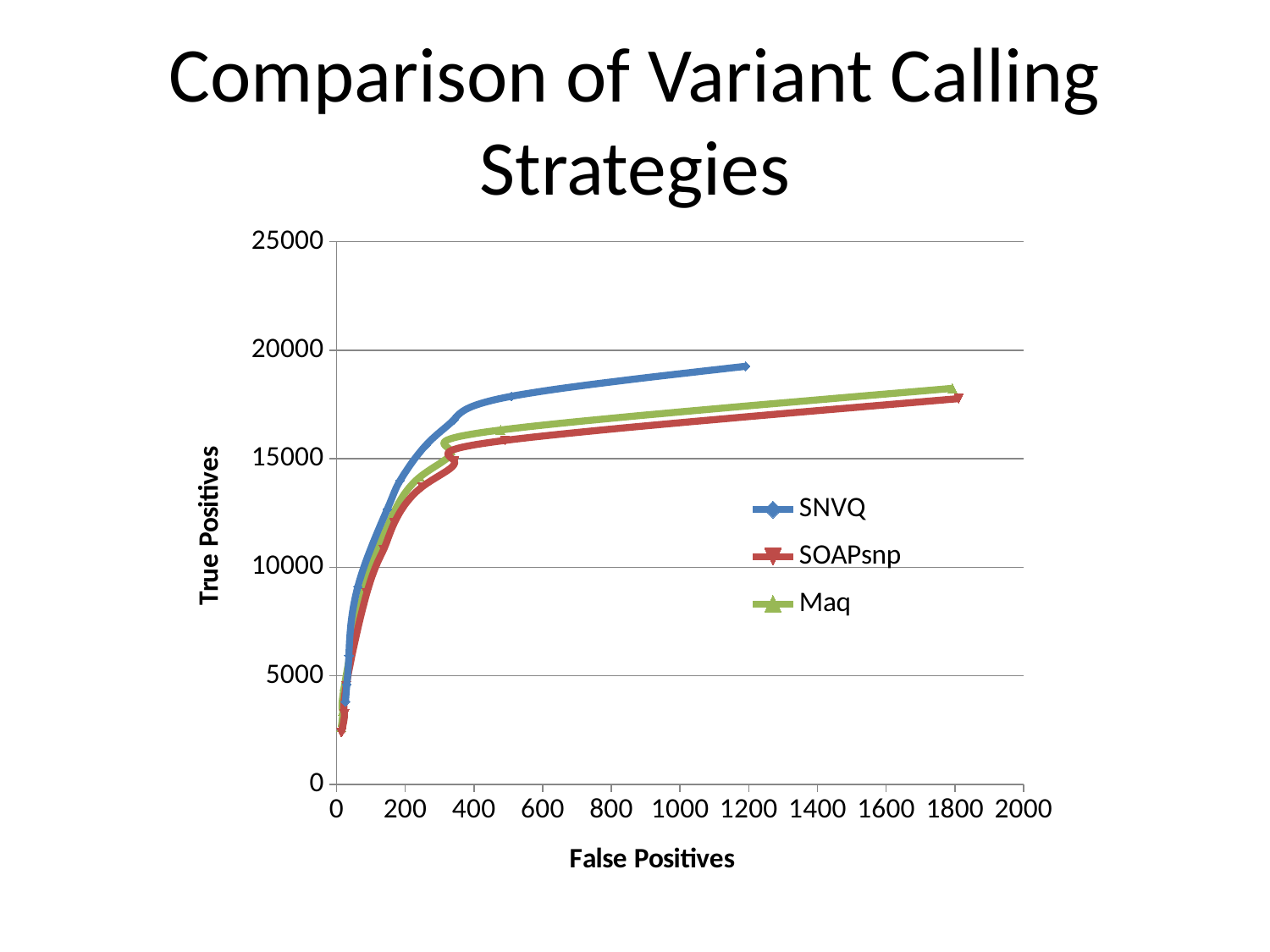
What is the label of the x axis? False Positives Is the lowest True Positives value of the SOAPsnp series greater or less than 5000? less Do the True Positives values rise or fall as False Positives increase along the x axis? rise Is the largest False Positives value reached by Maq greater or less than 1600? greater At 1800 False Positives, which series has more True Positives, Maq or SOAPsnp? Maq Is the highest True Positives value reached by SNVQ greater or less than 20000? less What is the title of the chart? Comparison of Variant Calling Strategies How many series does the legend list? 3 What kind of chart is shown on the slide? line chart Which series reaches the highest number of True Positives? SNVQ